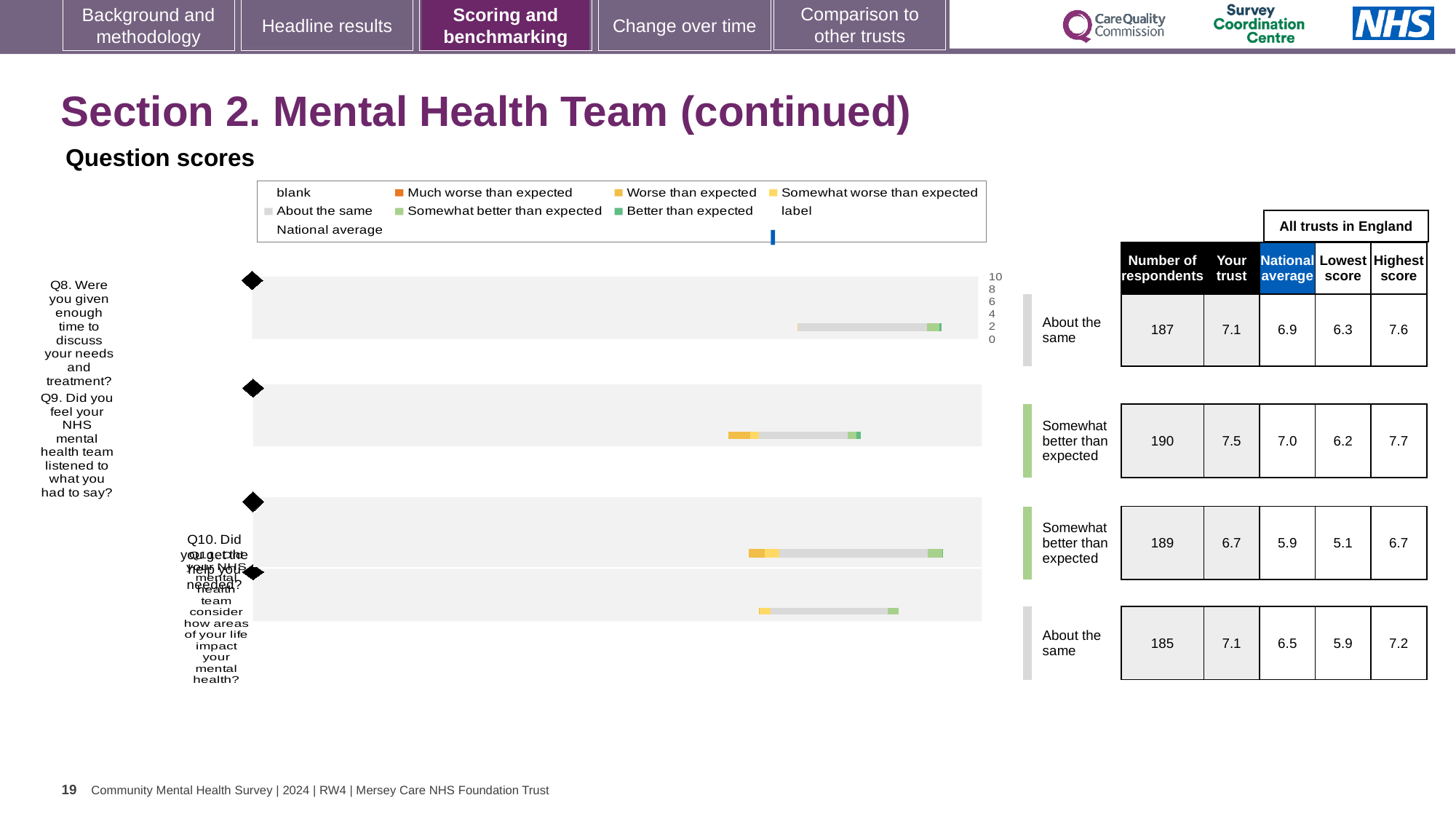
What kind of chart is used to show the question scores on this slide? bar chart Which question has the highest 'Your trust' score? Q9 What is the lowest score among all trusts in England for Q10? 5.1 What is the difference between the 'Your trust' score and the national average for Q9? 0.5 Which question has the lowest national average score? Q10 What is the national average score for Q8 (Were you given enough time to discuss your needs and treatment?)? 6.9 What is the 'Your trust' score for Q9 (Did you feel your NHS mental health team listened to what you had to say?)? 7.5 How many respondents answered Q10 (Did you get the help you needed?)? 189 How many questions (bars) are plotted in the question scores chart? 4 What benchmark category is shown for Q9? Somewhat better than expected What is the highest score among all trusts in England for Q11? 7.2 For Q8, which is larger: the 'Your trust' score or the national average? Your trust